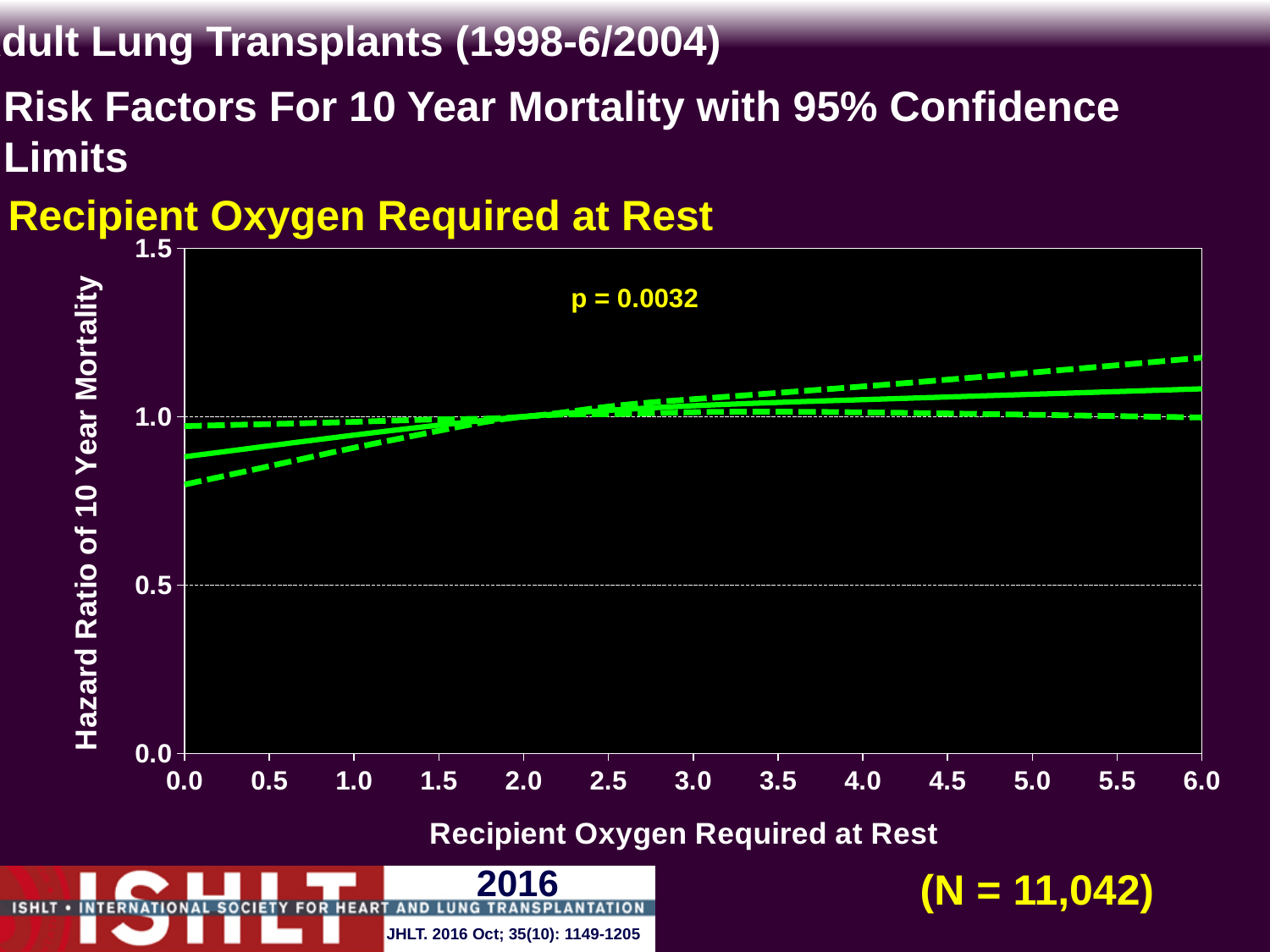
Is the upper 95% confidence limit (upper dashed line) at a recipient oxygen value of 6.0 greater or less than 1.0? greater What sample size (N) is shown on the slide? N = 11,042 Is the hazard ratio (solid line) at a recipient oxygen value of 6.0 greater or less than 1.0? greater Is the lower 95% confidence limit (lower dashed line) at a recipient oxygen value of 0.0 greater or less than 1.0? less How many tick labels are shown on the x axis? 13 What kind of chart is shown on the slide? line chart Is the hazard ratio (solid line) higher at a recipient oxygen value of 6.0 or at 0.0? 6.0 What p-value is printed on the chart? p = 0.0032 Does the hazard ratio of 10 year mortality rise or fall as recipient oxygen required at rest increases from 0.0 to 6.0? rise How many lines are plotted on the chart? 3